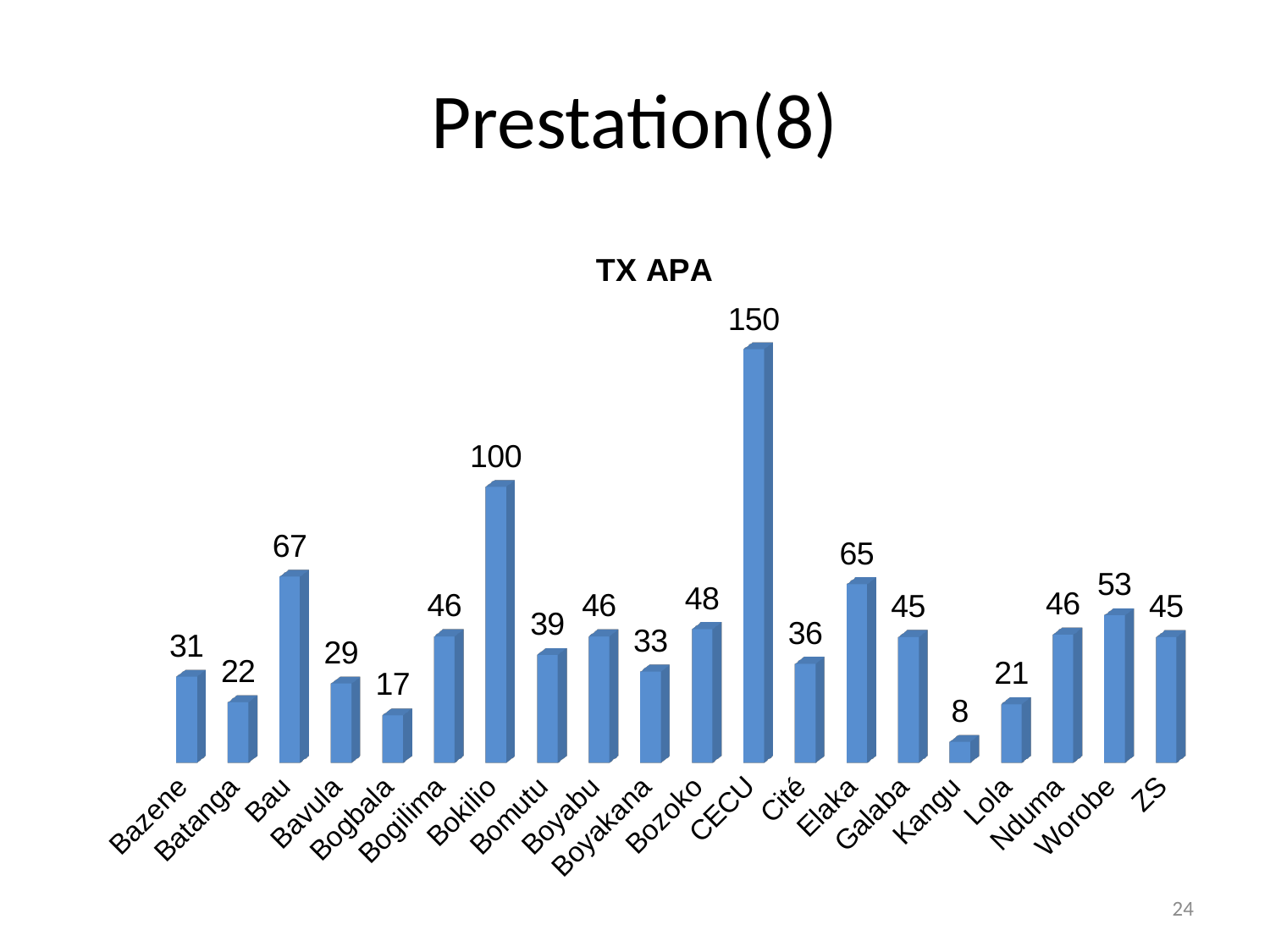
How many categories are shown on the x axis? 20 Which is larger, the value for Bau or the value for Bozoko? Bau What kind of chart is shown? Bar chart Which category has the highest value? CECU Which category has the lowest value? Kangu What is the difference between the values for CECU and Bokilio? 50 What is the value for Bokilio? 100 What is the title of the chart? TX APA What is the value for Kangu? 8 What is the value for CECU? 150 What is the difference between the values for Bau and Elaka? 2 What is the value for Worobe? 53